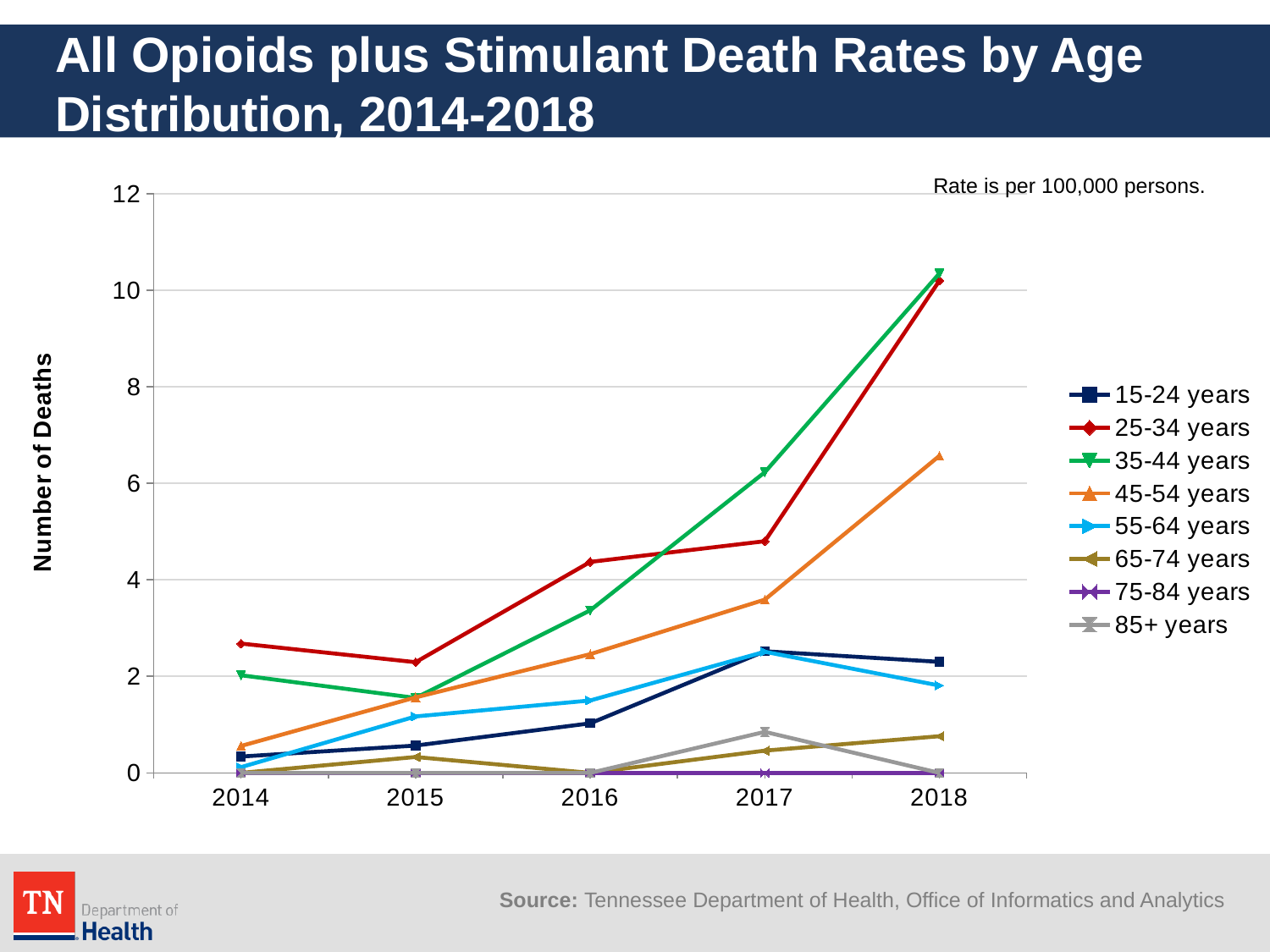
Does the value for 45-54 years rise or fall from 2014 to 2018? rise Which age group has the highest value in 2016? 25-34 years What type of chart is shown on the slide? Line chart How many years are shown along the x axis? 5 In 2017, which is larger: the value for 25-34 years or the value for 45-54 years? 25-34 years How many age groups does the legend list? 8 Is the value for 55-64 years in 2018 greater or less than 2? less Is the value for 35-44 years in 2018 greater or less than 8? greater Is the value for 45-54 years in 2018 greater or less than 6? greater What is the title of the y axis? Number of Deaths Which age group has the highest value in 2017? 35-44 years Which age group has the lowest value in 2017? 75-84 years